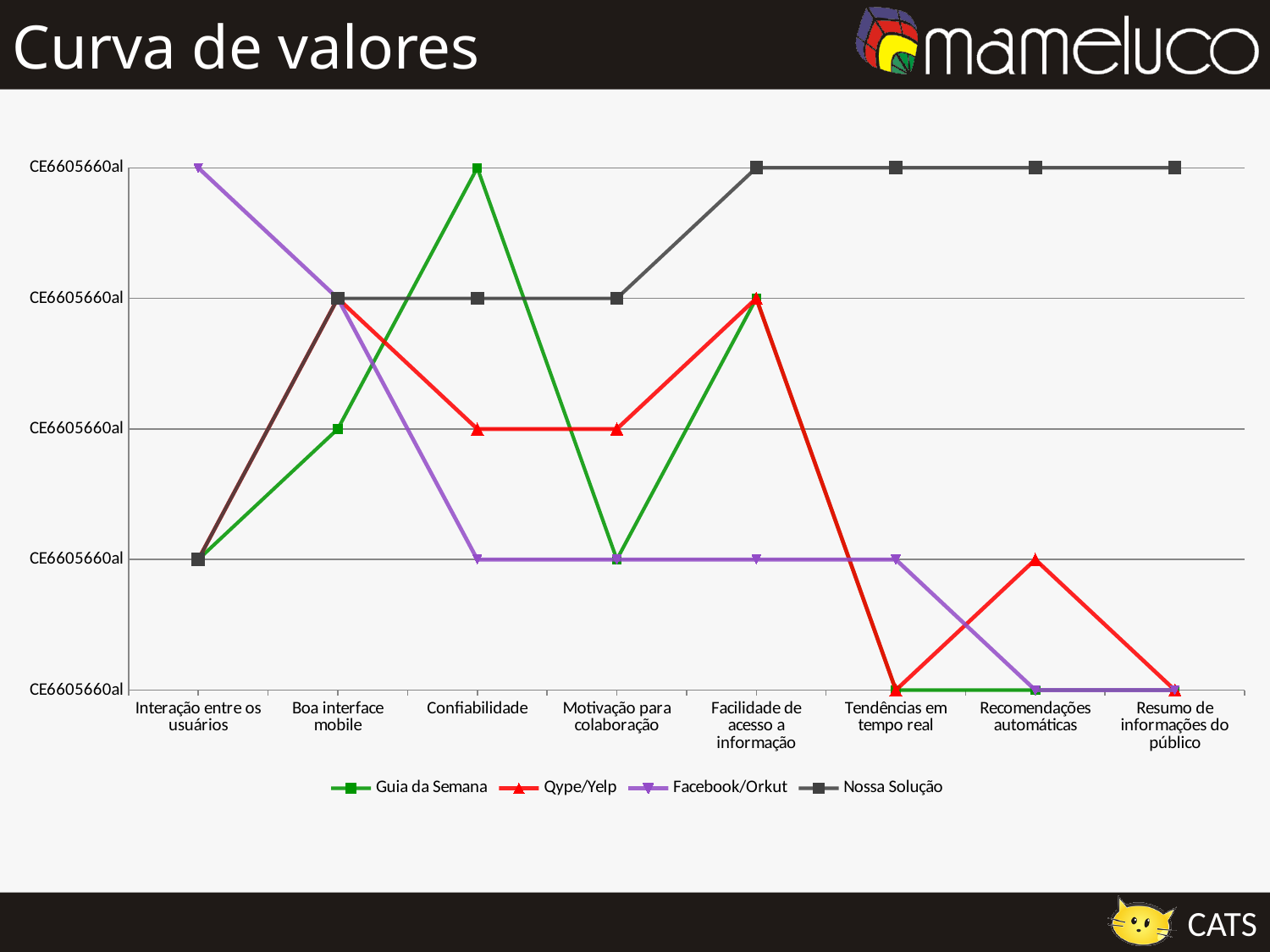
At "Confiabilidade", which series is higher, Guia da Semana or Facebook/Orkut? Guia da Semana For the Facebook/Orkut series, at which category is the value highest? Interação entre os usuários At "Tendências em tempo real", which series has the highest value? Nossa Solução How many series does the legend list? 4 Does the Nossa Solução series rise or fall from "Interação entre os usuários" to "Facilidade de acesso a informação"? Rise At "Interação entre os usuários", which series is higher, Facebook/Orkut or Nossa Solução? Facebook/Orkut Does the Qype/Yelp series rise or fall from "Facilidade de acesso a informação" to "Tendências em tempo real"? Fall How many categories are shown along the x axis? 8 What are the series names listed in the legend? Guia da Semana, Qype/Yelp, Facebook/Orkut, Nossa Solução For the Guia da Semana series, at which category is the value highest? Confiabilidade What kind of chart is shown on the slide? Line chart What is the title of the slide containing the chart? Curva de valores